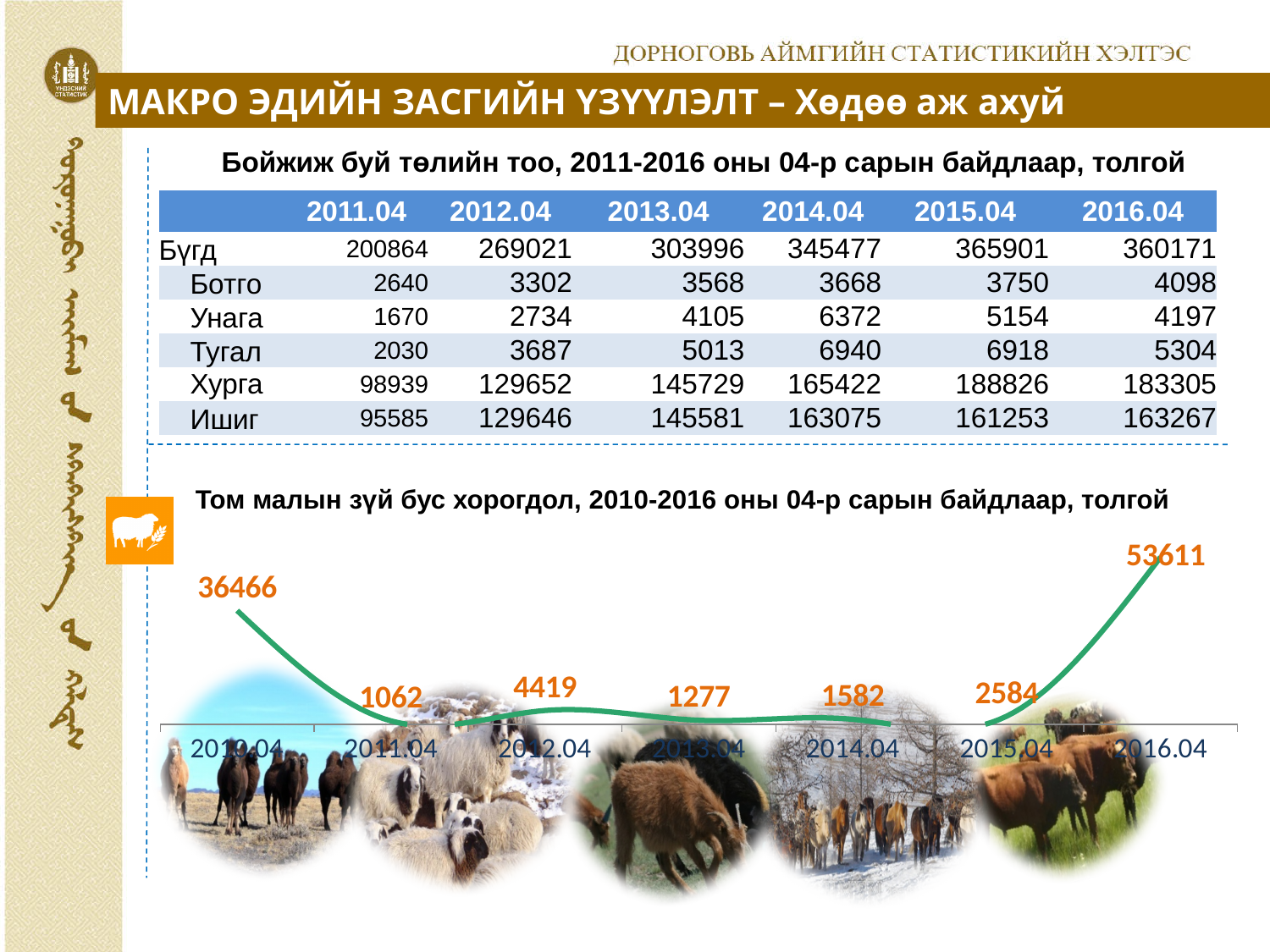
In the line chart, which period has the lowest value? 2011.04 In the line chart, what is the value for 2012.04? 4419 In the line chart, what is the value for 2010.04? 36466 In the line chart, what is the difference between the values for 2015.04 and 2014.04? 1002 In the line chart, what is the value for 2016.04? 53611 In the line chart, do the values rise or fall from 2013.04 to 2016.04? rise In the line chart, which period has the highest value? 2016.04 In the line chart, which is larger, the value for 2012.04 or the value for 2013.04? 2012.04 How many data points are plotted in the line chart? 7 What type of chart is shown at the bottom of the slide? line chart In the line chart, what is the value for 2014.04? 1582 In the line chart, what is the difference between the values for 2016.04 and 2010.04? 17145